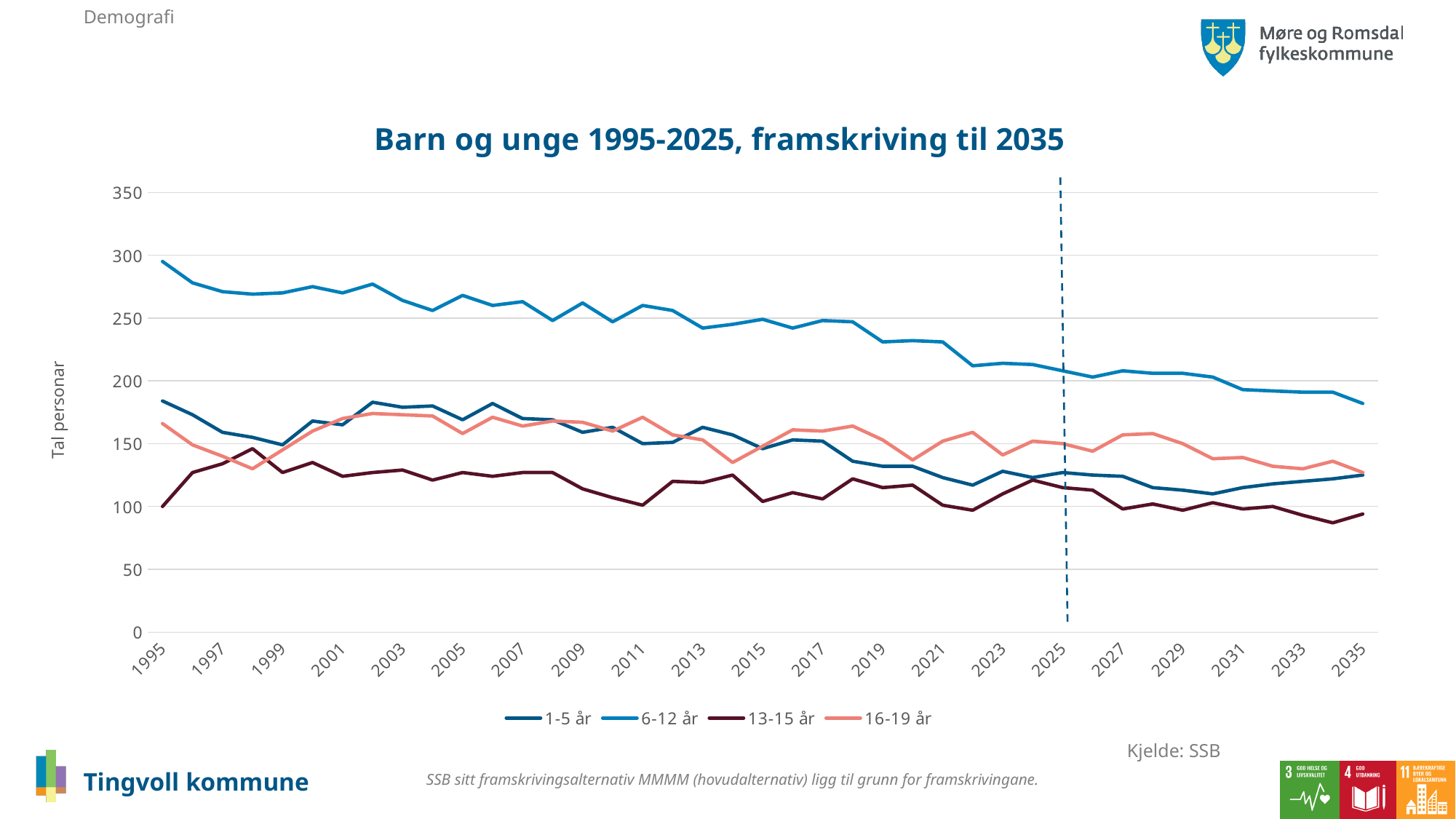
Is the value for 6-12 år in 2035 greater or less than 200? less Is the value for 13-15 år in 1995 greater or less than 150? less What is the label on the vertical axis? Tal personar What kind of chart is shown on the slide? line chart Is the value for 6-12 år in 1995 greater or less than 250? greater What is the title of the chart? Barn og unge 1995-2025, framskriving til 2035 In 2035, which is larger: the value for 1-5 år or the value for 13-15 år? 1-5 år Which series has the lowest value in 2035? 13-15 år In 1995, which is larger: the value for 1-5 år or the value for 16-19 år? 1-5 år How many series does the legend list? 4 Does the 6-12 år series rise or fall overall from 1995 to 2035? fall Which series has the highest value in 1995? 6-12 år